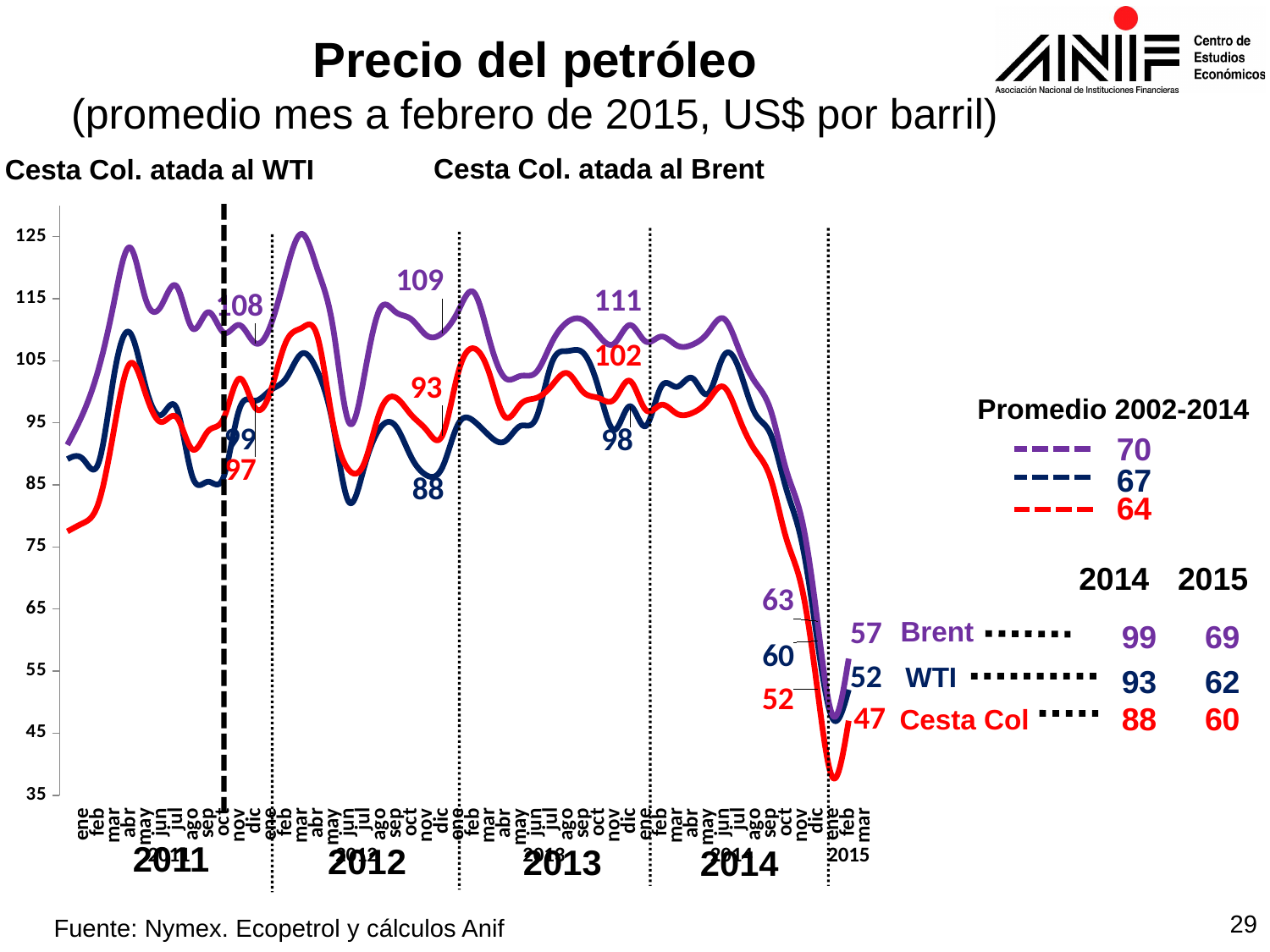
What is the labelled value for Cesta Col in February 2015? 47 What is the labelled value for Cesta Col in December 2013? 102 Which series has the highest labelled value in December 2013? Brent What type of chart is shown on the slide? line chart What is the labelled value for WTI in December 2012? 88 What is the 2014 average for WTI shown in the table? 93 What is the difference between the Brent and Cesta Col labelled values in December 2014 (63 and 52)? 11 What is the 2002-2014 average (Promedio) for Brent? 70 Do the three series rise or fall between mid-2014 and January 2015? fall How many series does the legend list? 3 Which is larger in December 2013: the WTI value or the Cesta Col value? Cesta Col What is the labelled value for Brent in December 2012? 109